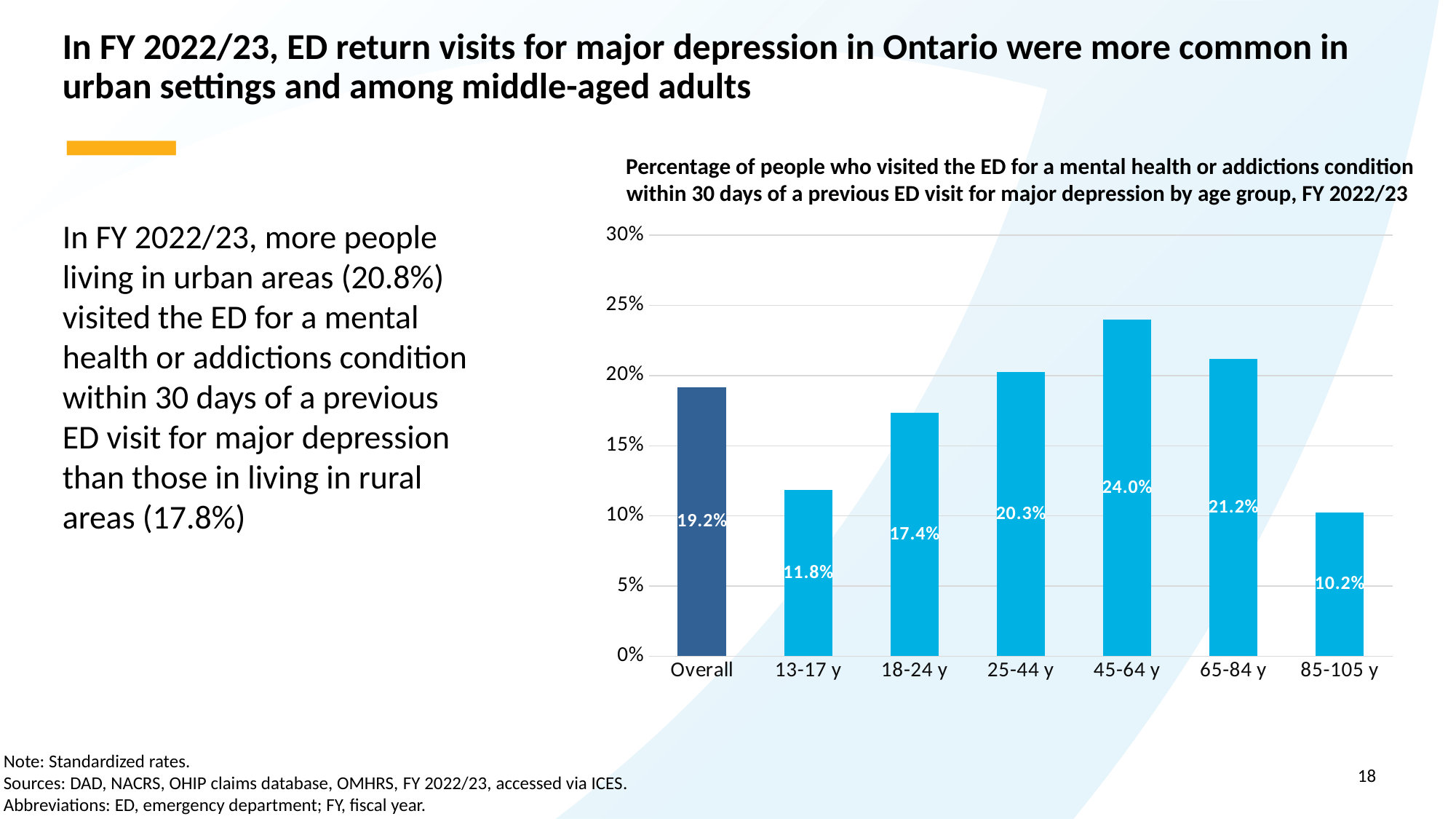
How many bars are shown in the chart? 7 Is the value for 65-84 y greater or less than 20%? greater Which age group has the highest value? 45-64 y Which is larger, the value for 18-24 y or the value for 25-44 y? 25-44 y What is the value for the Overall bar? 19.2% What is the value for the 85-105 y age group? 10.2% What is the difference between the values for 65-84 y and Overall? 2.0% What kind of chart is shown on the slide? Bar chart What is the value for the 45-64 y age group? 24.0% Which bar is shown in a darker blue colour than the others? Overall Which age group has the lowest value? 85-105 y What is the difference between the values for 45-64 y and 13-17 y? 12.2%